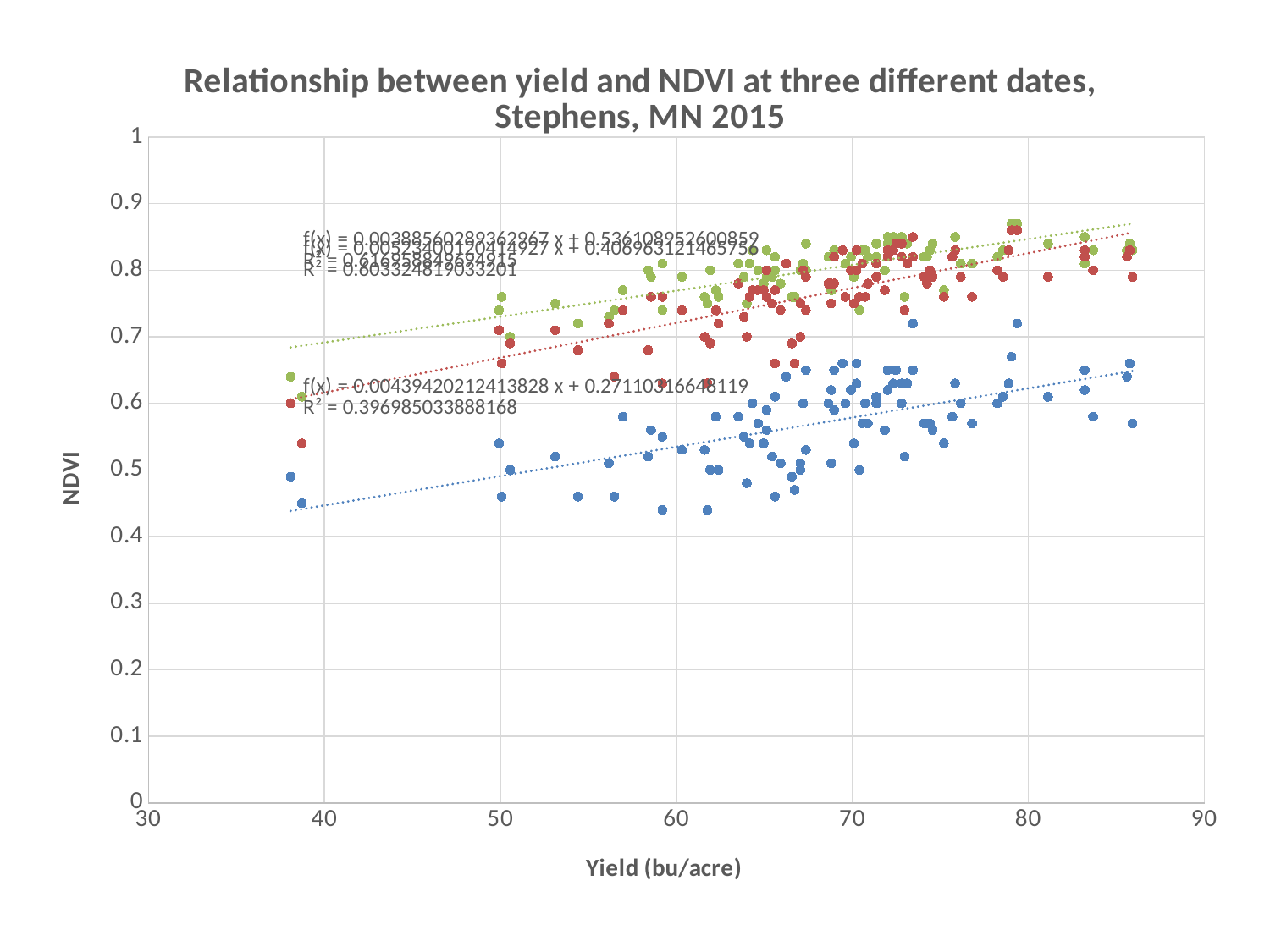
How many data series (colours of points) are plotted on the chart? 3 Is the highest blue point's NDVI value greater or less than 0.8? less At a yield of about 38 bu/acre, which series has the higher NDVI, green or blue? green What kind of chart is shown on the slide? scatter chart Is the NDVI value of the red points at a yield of about 38 bu/acre greater or less than 0.7? less Do the blue points' NDVI values generally rise or fall as yield increases? rise What is the R² value shown for the blue series trendline? 0.396985033888168 Is the lowest blue point's NDVI value greater or less than 0.5? less What is the title of the chart? Relationship between yield and NDVI at three different dates, Stephens, MN 2015 What is the label of the x axis? Yield (bu/acre) Which series has the lowest NDVI values overall: blue, red or green? blue What is the slope (coefficient of x) in the trendline equation shown for the blue series? 0.00439420212413828